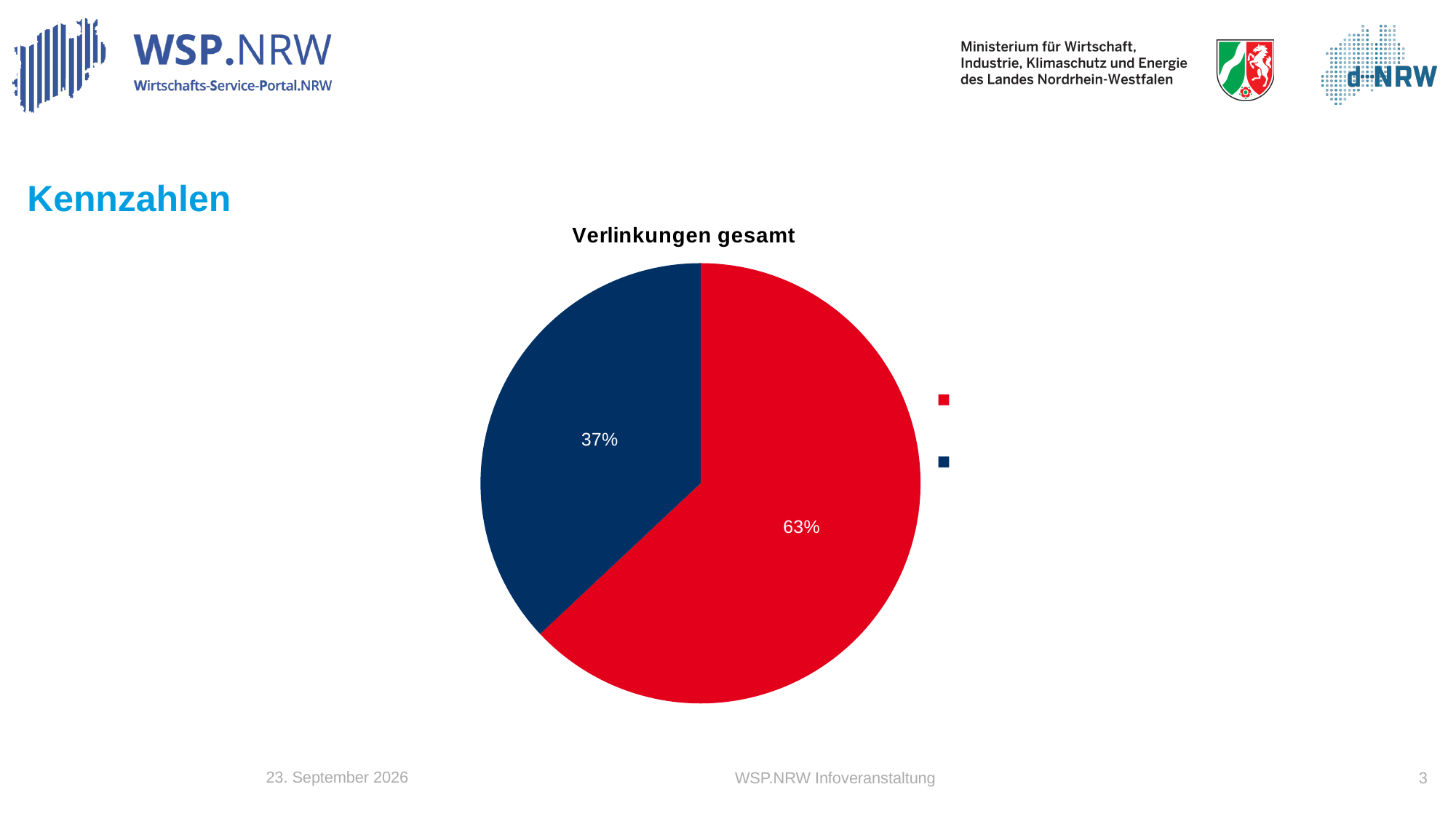
What is the title of the chart? Verlinkungen gesamt What share of the pie does the dark blue slice represent? 37% What colour is the slice labelled 37%? dark blue How many slices does the pie chart have? 2 Which slice of the pie is the largest? the red slice (63%) Is the share of the red slice greater or less than 50%? greater What share of the pie does the red slice represent? 63% What kind of chart is shown on the slide? pie chart Which slice is larger, the red one or the dark blue one? the red one What is the difference in percentage points between the red slice and the dark blue slice? 26 percentage points How many entries does the legend show? 2 Which slice of the pie is the smallest? the dark blue slice (37%)